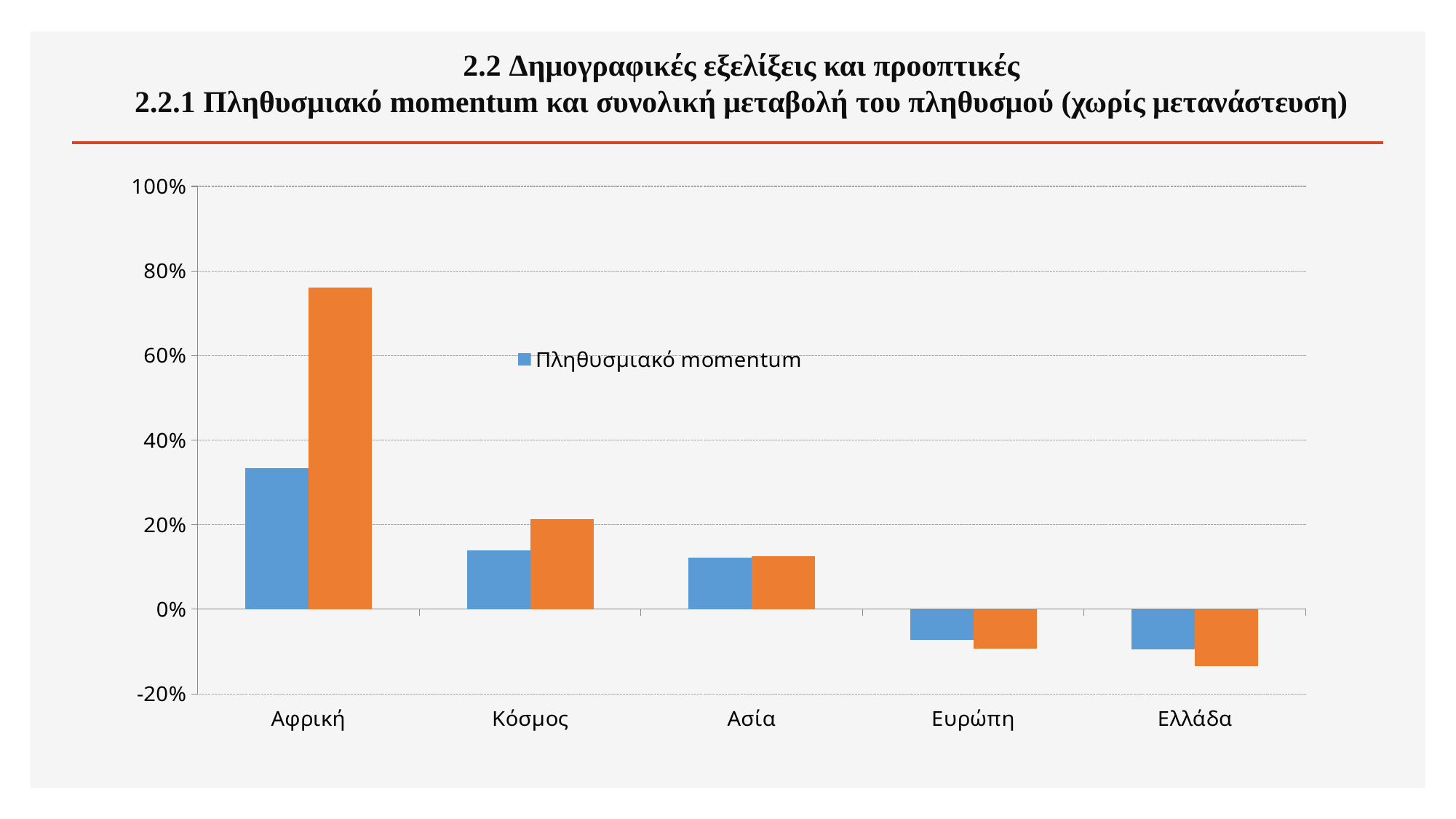
Which is larger, the Πληθυσμιακό momentum (blue bar) for Αφρική or for Κόσμος? Αφρική How many categories are shown on the x axis of the chart? 5 Is the orange bar for Αφρική greater or less than 60%? greater Do the Πληθυσμιακό momentum (blue bar) values rise or fall from Αφρική to Ελλάδα along the x axis? fall What kind of chart is shown on the slide? bar chart How many series does the chart's legend list? 1 Is the Πληθυσμιακό momentum (blue bar) for Κόσμος greater or less than 20%? less Is the Πληθυσμιακό momentum (blue bar) for Αφρική greater or less than 40%? less Which category has the tallest orange bar? Αφρική Which category has the highest value for Πληθυσμιακό momentum (blue bars)? Αφρική What is the series name shown in the chart's legend? Πληθυσμιακό momentum Which category has the lowest value for Πληθυσμιακό momentum (blue bars)? Ελλάδα